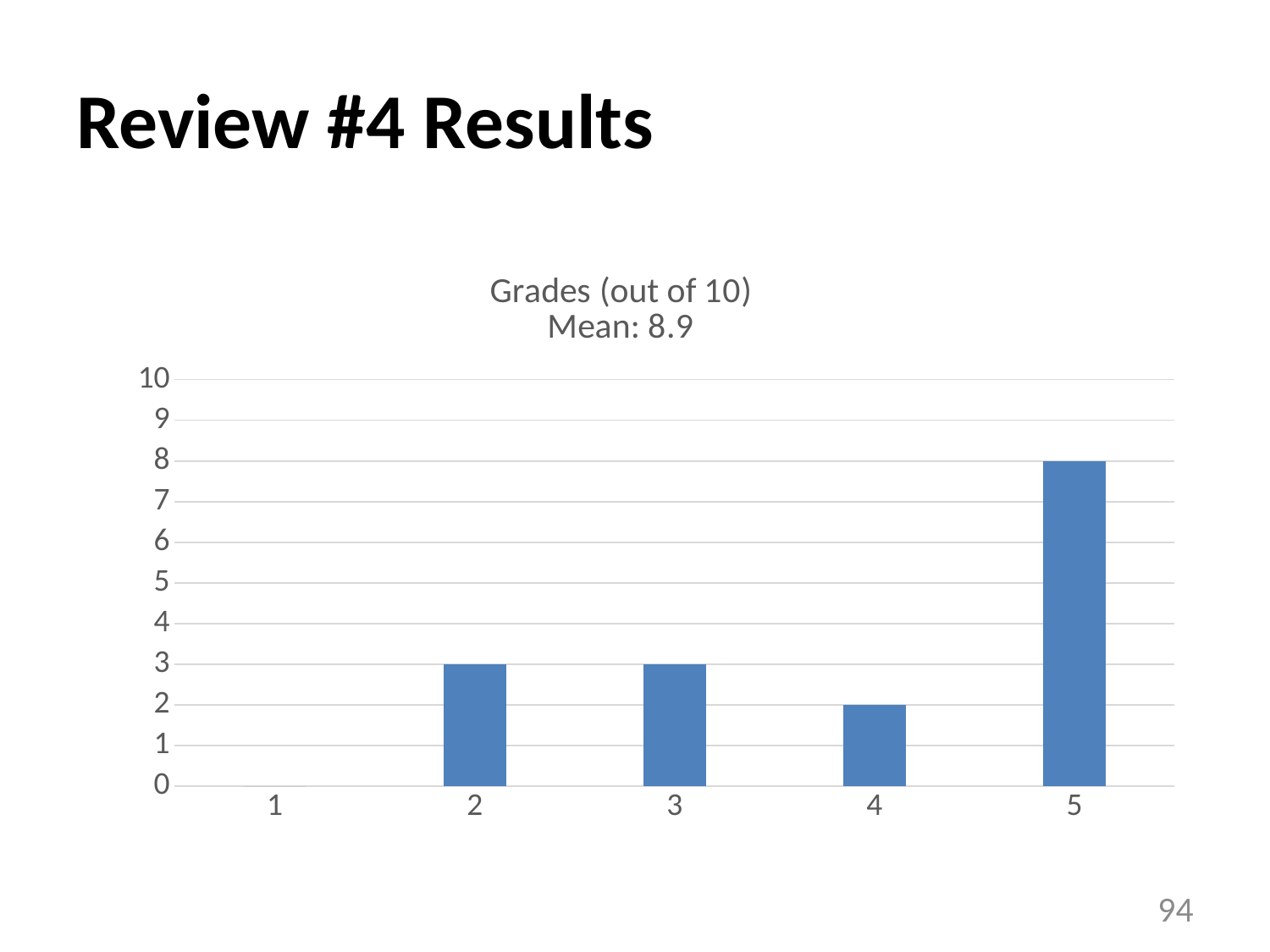
What is the title of the chart? Grades (out of 10) Mean: 8.9 Is the value for category 5 greater or less than 5? greater What is the value for category 5? 8 What kind of chart is shown on the slide? bar chart What mean is stated in the chart title? 8.9 Which category has the highest value? 5 What is the value for category 4? 2 What is the value for category 2? 3 Which is larger, the value for category 3 or the value for category 4? 3 How many categories are shown on the x axis? 5 What is the difference between the values for category 5 and category 4? 6 Which category has the lowest value? 1